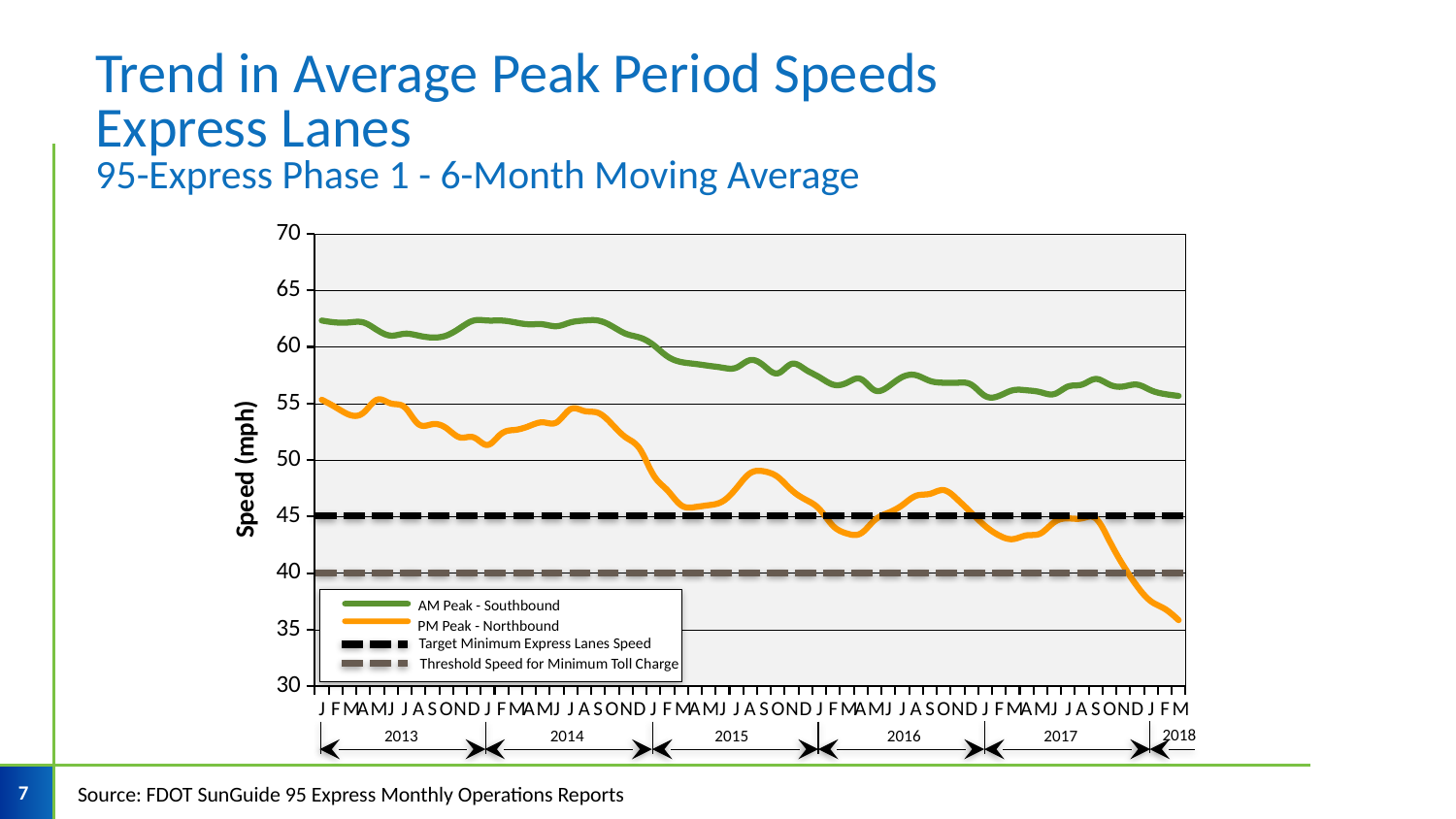
What is the label on the y axis? Speed (mph) What speed does the Target Minimum Express Lanes Speed line sit at? 45 How many series does the legend list? 4 Does the PM Peak - Northbound speed rise or fall from 2013 to 2018? fall What is the difference between the Target Minimum Express Lanes Speed and the Threshold Speed for Minimum Toll Charge? 5 Is the PM Peak - Northbound speed in March 2018 greater or less than 40? less Does the AM Peak - Southbound speed rise or fall from 2013 to 2018? fall Which series is higher throughout the chart, AM Peak - Southbound or PM Peak - Northbound? AM Peak - Southbound What speed does the Threshold Speed for Minimum Toll Charge line sit at? 40 Is the AM Peak - Southbound speed in January 2013 greater or less than 60? greater How many years are labelled along the x axis? 6 What kind of chart is shown on the slide? line chart